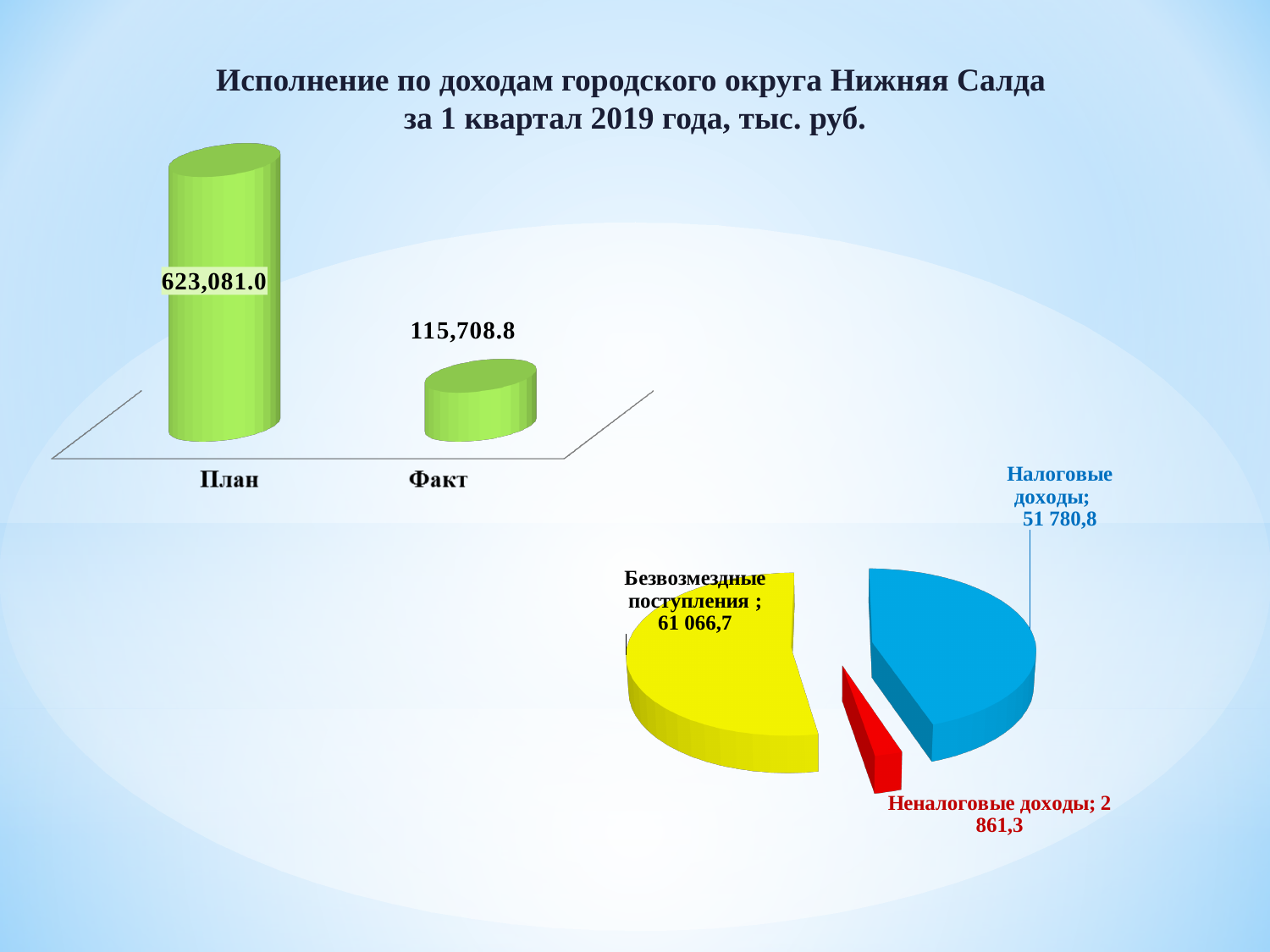
In the pie chart on the right, what is the value for Неналоговые доходы? 2 861,3 In the pie chart on the right, which slice is the largest? Безвозмездные поступления In the bar chart on the left, what is the value for Факт? 115,708.8 In the bar chart on the left, what is the value for План? 623,081.0 In the pie chart on the right, what is the value for Безвозмездные поступления? 61 066,7 In the pie chart on the right, which slice is the smallest? Неналоговые доходы In the bar chart on the left, how many categories are shown? 2 In the pie chart on the right, what colour is the Неналоговые доходы slice? Red In the bar chart on the left, what is the difference between the План and Факт values? 507,372.2 What kind of chart is shown on the left of the slide? Bar chart In the pie chart on the right, what is the value for Налоговые доходы? 51 780,8 In the bar chart on the left, which category has the higher value, План or Факт? План